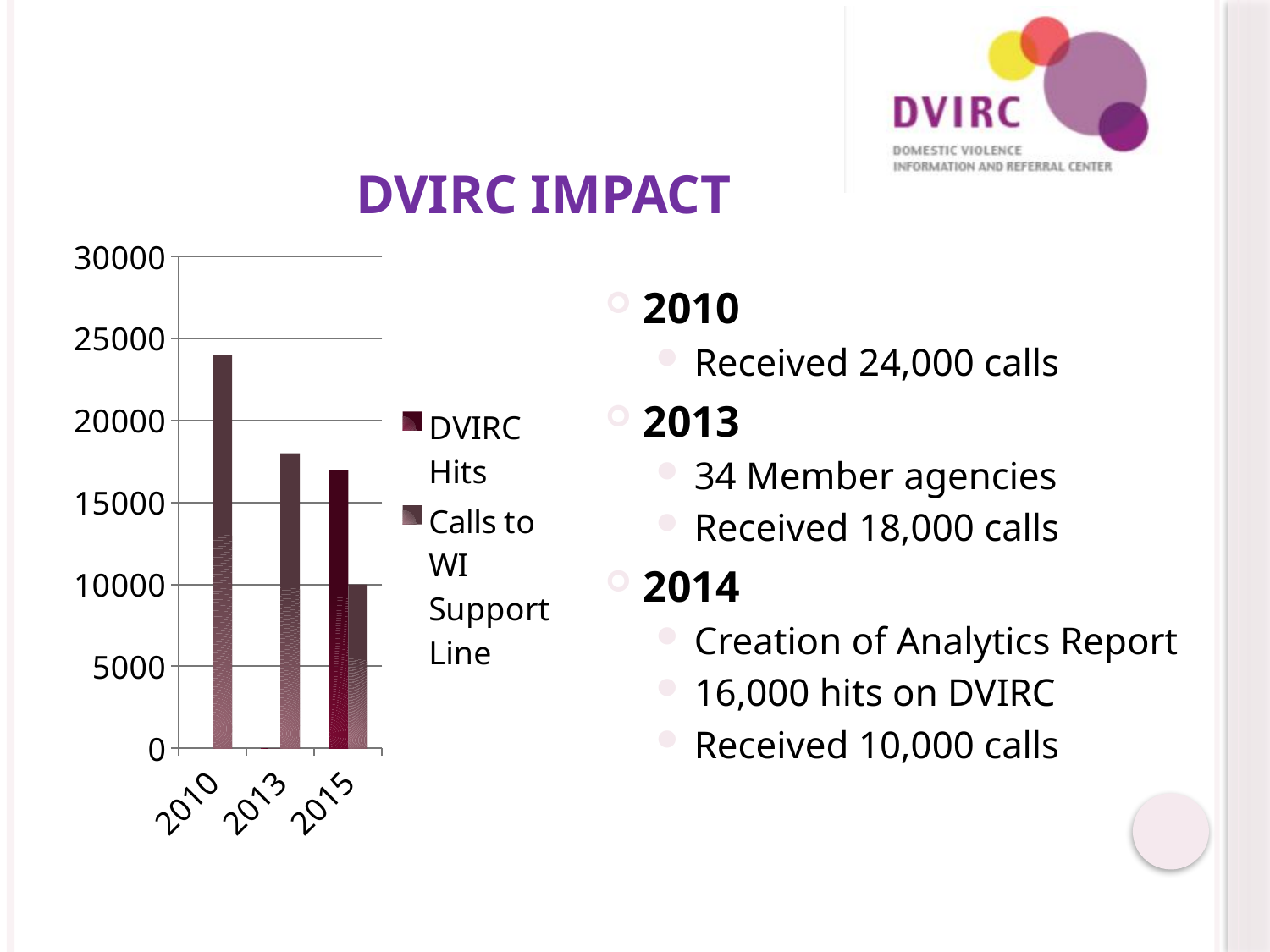
Is the value for Calls to WI Support Line in 2013 greater or less than 20000? less Which year has the lowest value for Calls to WI Support Line? 2015 How many years are shown on the x axis of the chart? 3 In 2015, which is larger: DVIRC Hits or Calls to WI Support Line? DVIRC Hits Is the value for DVIRC Hits in 2015 greater or less than 15000? greater Do the values for Calls to WI Support Line rise or fall from 2010 to 2015? fall What are the two series named in the chart's legend? DVIRC Hits and Calls to WI Support Line How many series does the chart's legend list? 2 What kind of chart is shown on the slide? bar chart Is the value for Calls to WI Support Line in 2013 greater or less than 15000? greater Which year has the highest value for Calls to WI Support Line? 2010